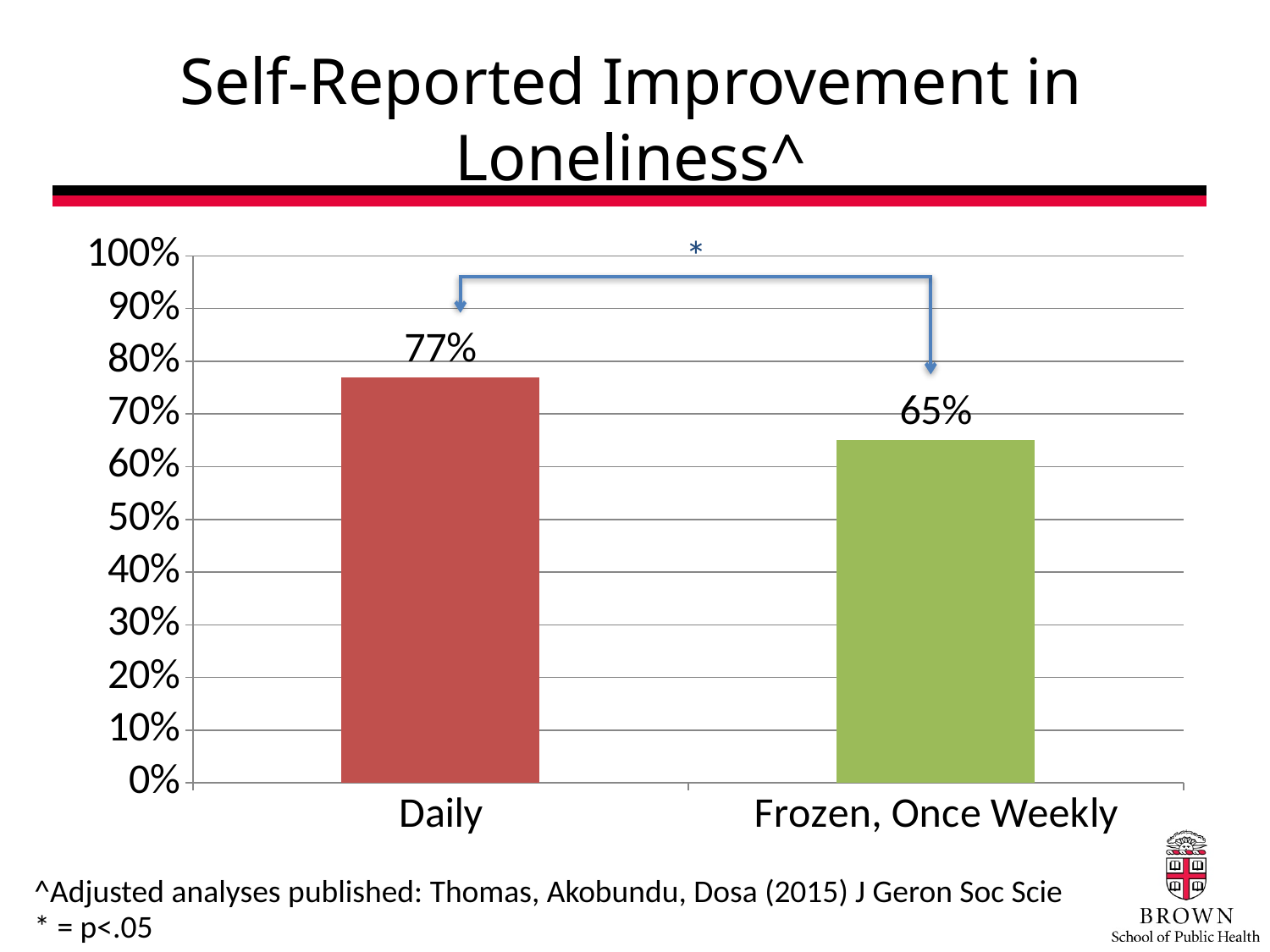
How many categories are shown on the x axis? 2 What is the difference between the values for Daily and Frozen, Once Weekly? 12% What is the title of the slide? Self-Reported Improvement in Loneliness^ What is the value for Daily? 77% What is the value for Frozen, Once Weekly? 65% Which is larger, the value for Daily or the value for Frozen, Once Weekly? Daily Which category has the lowest value? Frozen, Once Weekly What colour is the bar for Daily? red Which category has the highest value? Daily What kind of chart is shown on the slide? bar chart Is the value for Daily greater or less than 70%? greater Is the value for Frozen, Once Weekly greater or less than 70%? less